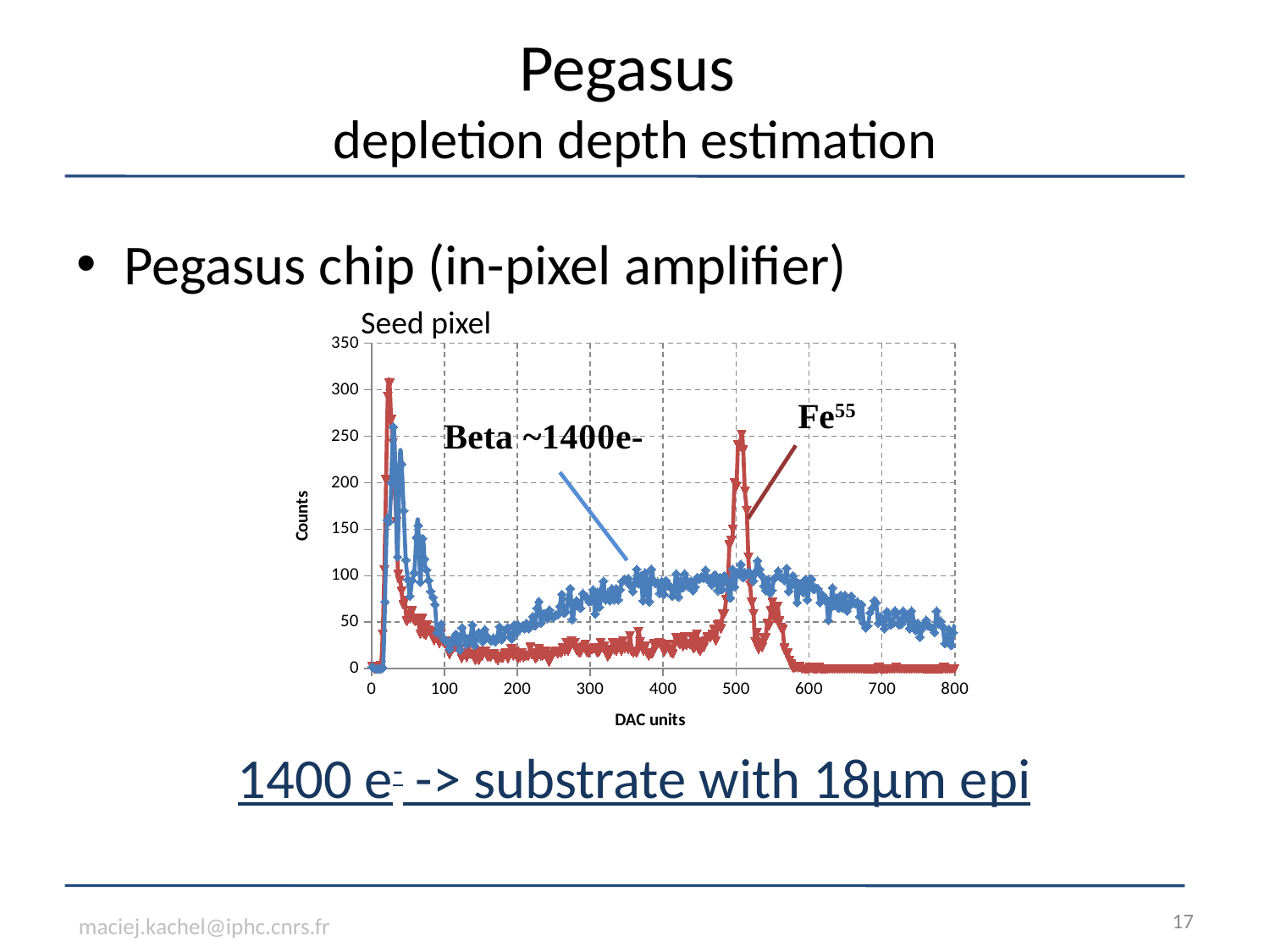
Is the peak value of the Fe55 series near 500 DAC units greater or less than 200 counts? greater What is the label of the x axis of the chart? DAC units Is the value of the Fe55 series at 300 DAC units greater or less than 50 counts? less What is the title of the chart? Seed pixel Is the highest value of the Fe55 series greater or less than 250 counts? greater How many data series are plotted in the chart? 2 At 500 DAC units, which series has the higher count, Beta or Fe55? Fe55 At 400 DAC units, which series has the higher count, Beta or Fe55? Beta What kind of chart is shown on the slide? line chart Does the Fe55 series rise or fall between 550 and 600 DAC units? fall